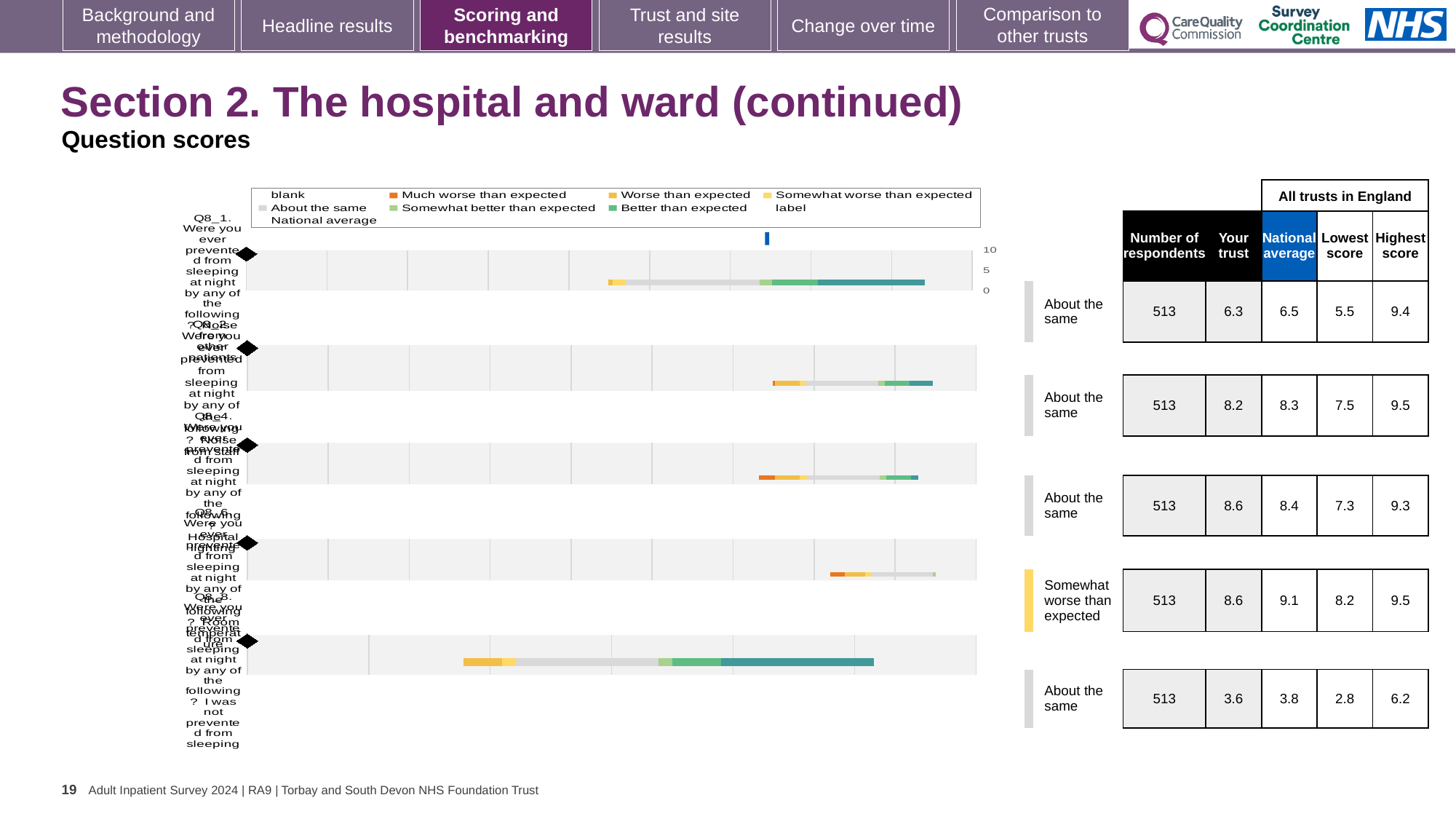
What is the number of respondents shown for the first (top) question row? 513 For the second question row, which is larger: the 'Your trust' score or the national average? National average What is the lowest score across all trusts in England for the third question row? 7.3 How many question rows (charts) are shown on the slide? 5 How many of the question rows are rated 'About the same'? 4 What is the lowest 'Your trust' score shown in the table on this slide? 3.6 For the first (top) question row, what is the 'Your trust' score in the table? 6.3 For the first (top) question row, what is the national average score? 6.5 What is the highest score across all trusts in England for the bottom question row? 6.2 What kind of chart is used to show the question scores on this slide? bar chart What benchmark category is shown for the fourth question row? Somewhat worse than expected For the fourth question row, what is the difference between the national average (9.1) and the 'Your trust' score (8.6)? 0.5